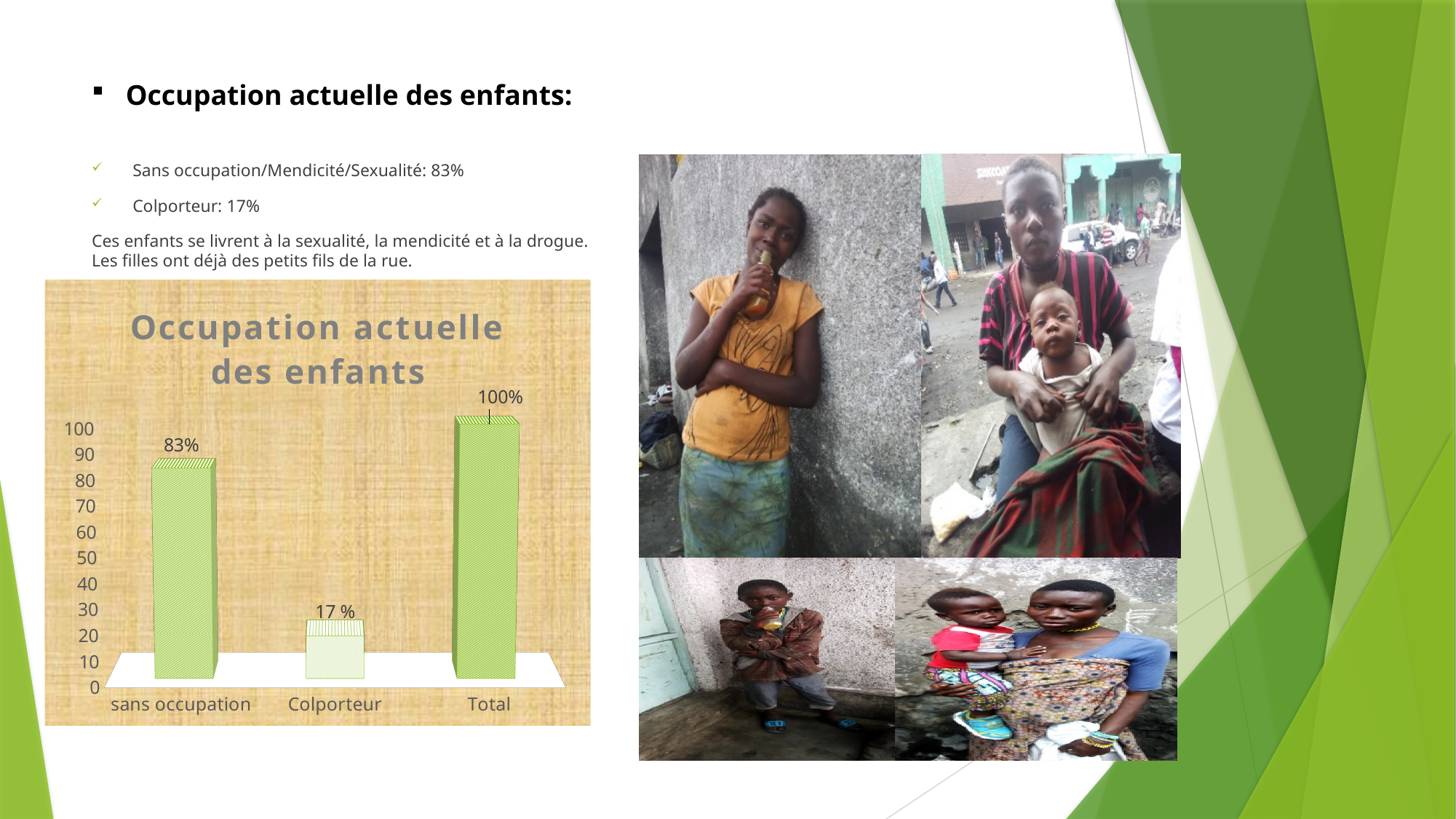
Which category has the highest value? Total How many categories are shown on the x axis? 3 What is the difference between the values for sans occupation and Colporteur? 66% What is the value for Colporteur? 17 % What type of chart is shown on the slide? bar chart Which is larger, the value for sans occupation or the value for Colporteur? sans occupation What is the title of the chart? Occupation actuelle des enfants Which category has the lowest value? Colporteur What is the value for Total? 100% What is the value for sans occupation? 83% Is the value for Colporteur greater or less than 20? less What is the highest tick value shown on the vertical axis? 100